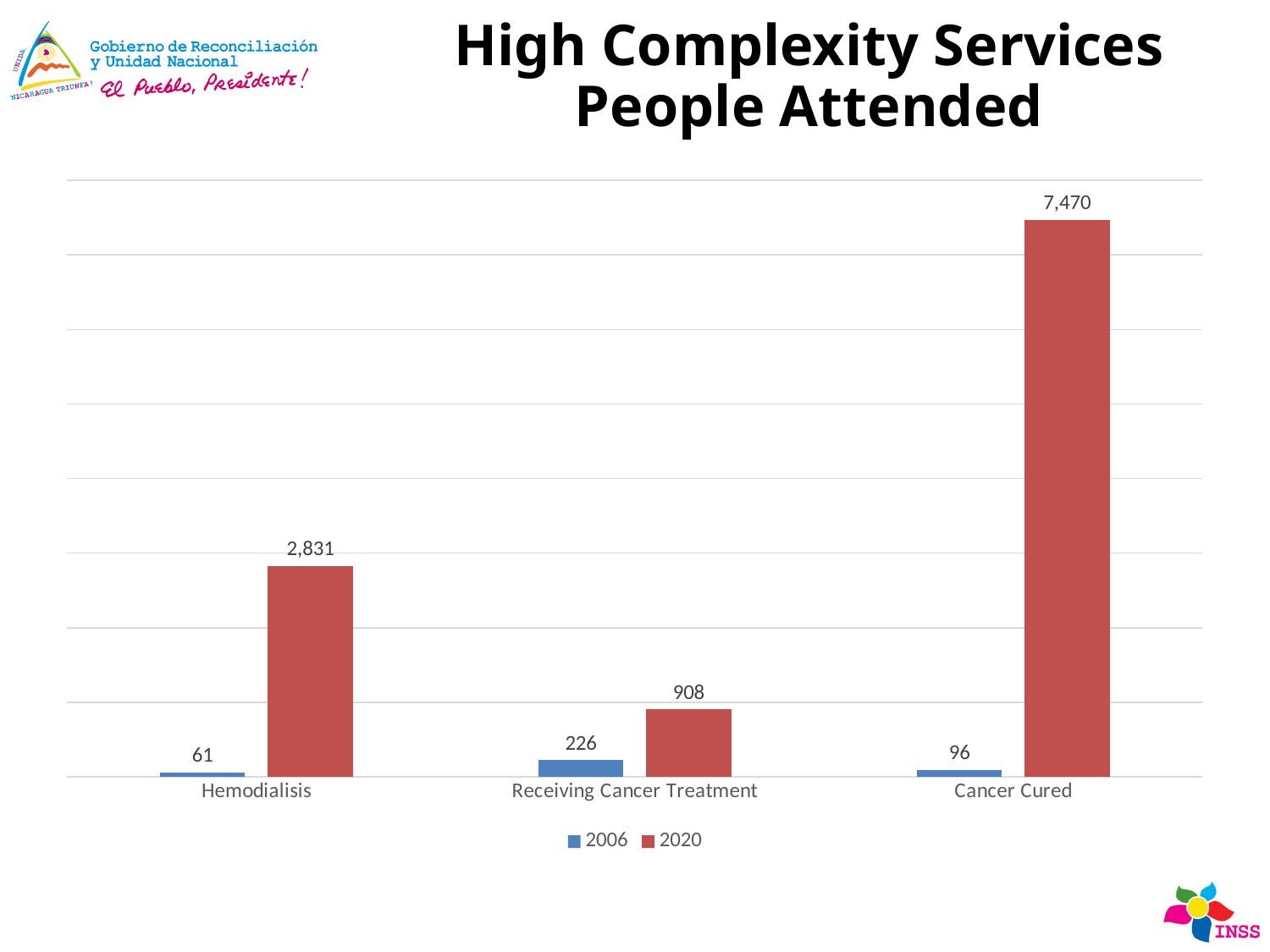
What was the value for Cancer Cured in 2020? 7,470 How many categories are shown on the x axis? 3 What kind of chart is shown on the slide? Bar chart What is the difference between the 2020 and 2006 values for Receiving Cancer Treatment? 682 What is the difference between the 2020 values for Cancer Cured and Hemodialisis? 4,639 What was the number of people attended for Hemodialisis in 2006? 61 Which category has the highest value in 2020? Cancer Cured How many series does the legend list? 2 Which is larger: the 2006 value for Receiving Cancer Treatment or the 2006 value for Cancer Cured? Receiving Cancer Treatment What was the number of people attended for Hemodialisis in 2020? 2,831 Which category has the lowest value in 2006? Hemodialisis What was the value for Receiving Cancer Treatment in 2006? 226